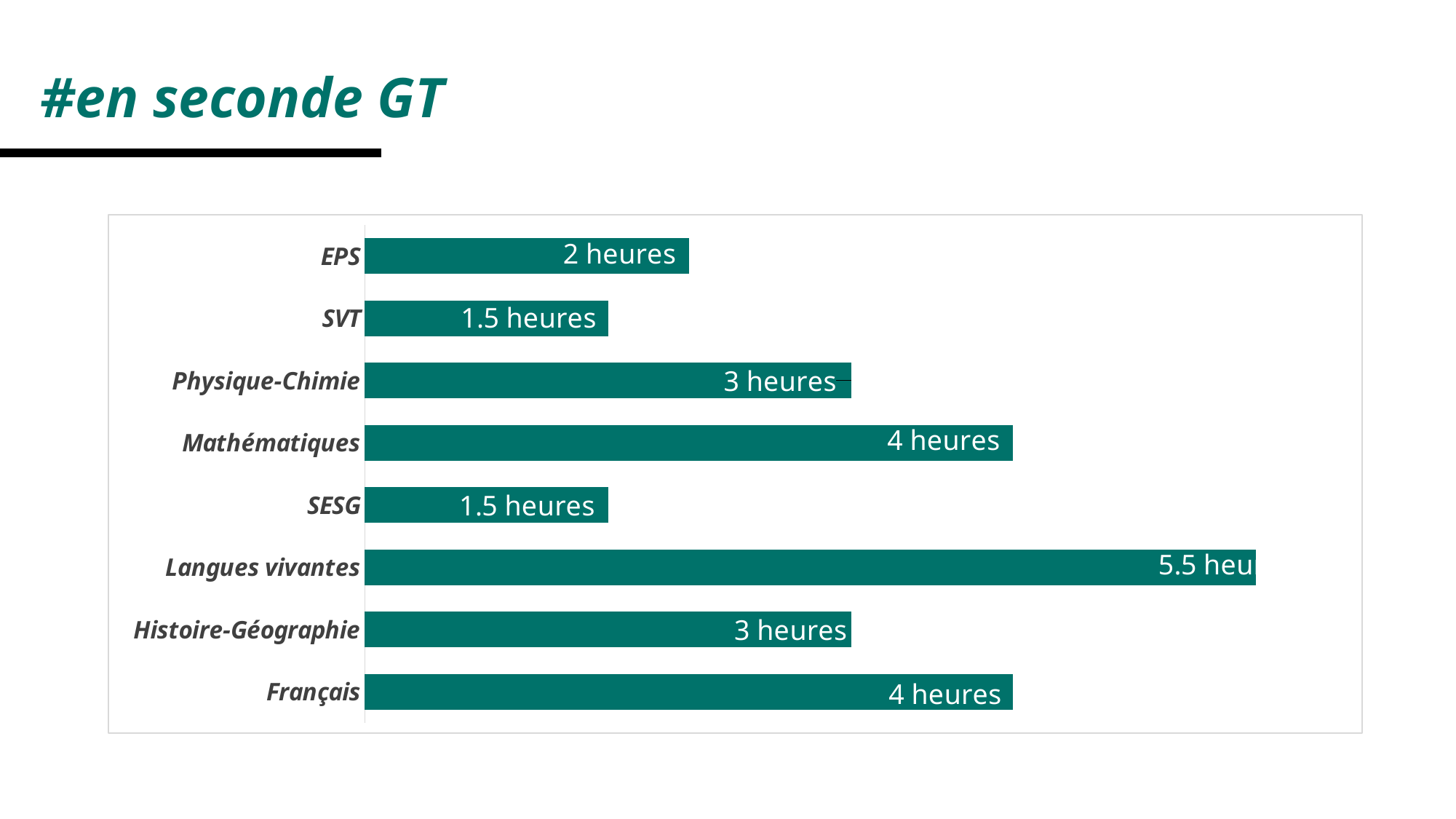
What kind of chart is shown on the slide? bar chart What is the value for EPS? 2 heures What is the value for SVT? 1.5 heures Which subject has the highest value in the chart? Langues vivantes How many categories (subjects) are shown in the chart? 8 Which is larger, the value for Français or the value for Physique-Chimie? Français Which is larger, the value for EPS or the value for SESG? EPS What is the difference between the value for Français and the value for SVT? 2.5 heures What is the value for Mathématiques? 4 heures What is the difference between the value for Mathématiques and the value for EPS? 2 heures What is the title of the slide containing the chart? #en seconde GT What is the value for Histoire-Géographie? 3 heures